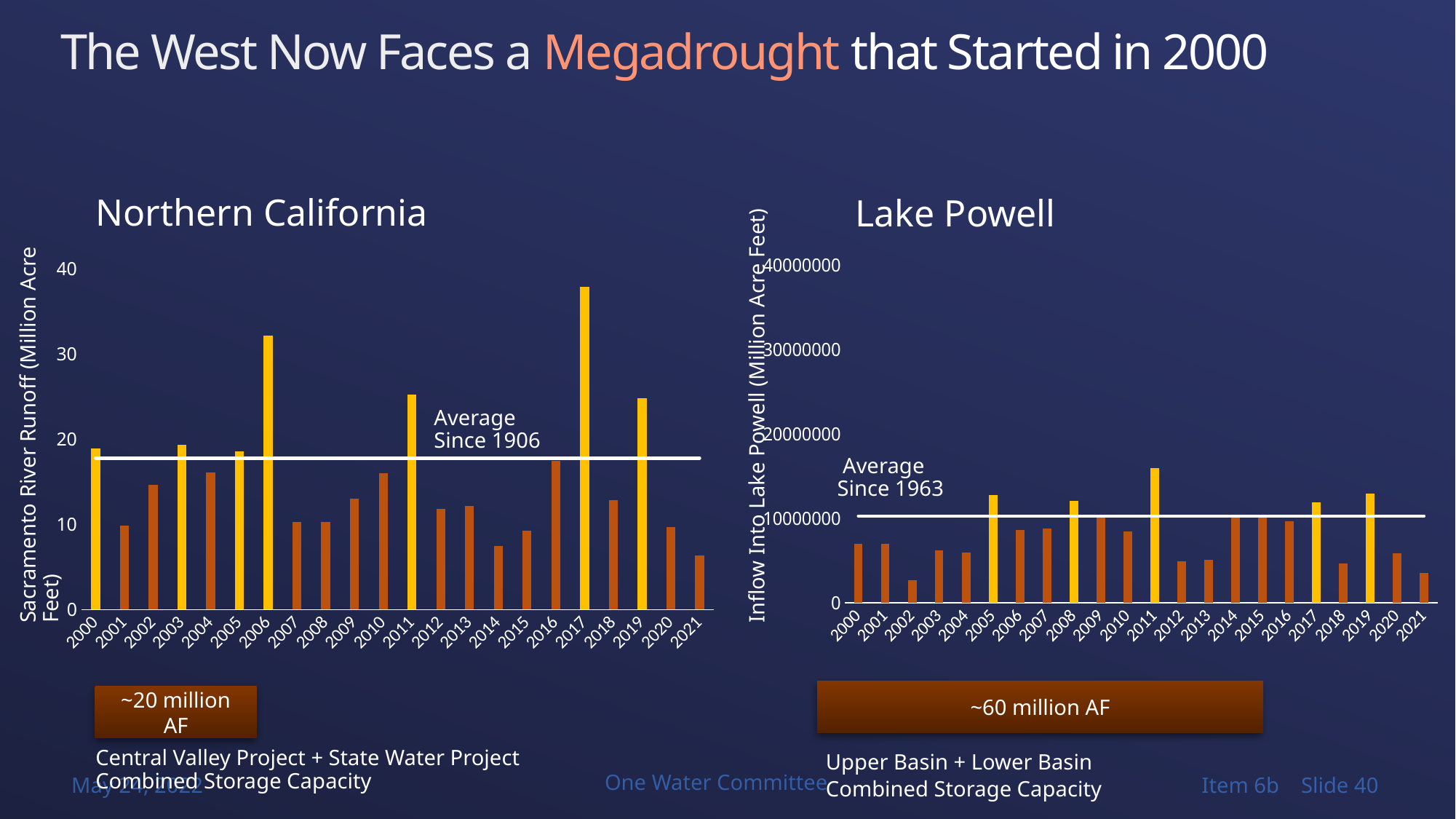
In the Northern California chart, is the runoff for 2006 greater or less than 30? greater In the Northern California chart, which year has the highest Sacramento River runoff? 2017 In the Lake Powell chart, which year has the highest inflow? 2011 How many years are shown on the x axis of the Lake Powell chart? 22 In the Lake Powell chart, is the inflow for 2011 greater or less than 10000000? greater In the Northern California chart, which year has the larger runoff, 2006 or 2011? 2006 In the Lake Powell chart, which year has the larger inflow, 2005 or 2011? 2011 In the Northern California chart, is the runoff for 2021 greater or less than 10? less In the Lake Powell chart, which year has the lowest inflow? 2002 What is the y-axis label of the Northern California chart? Sacramento River Runoff (Million Acre Feet) What kind of chart is the Northern California chart? bar chart